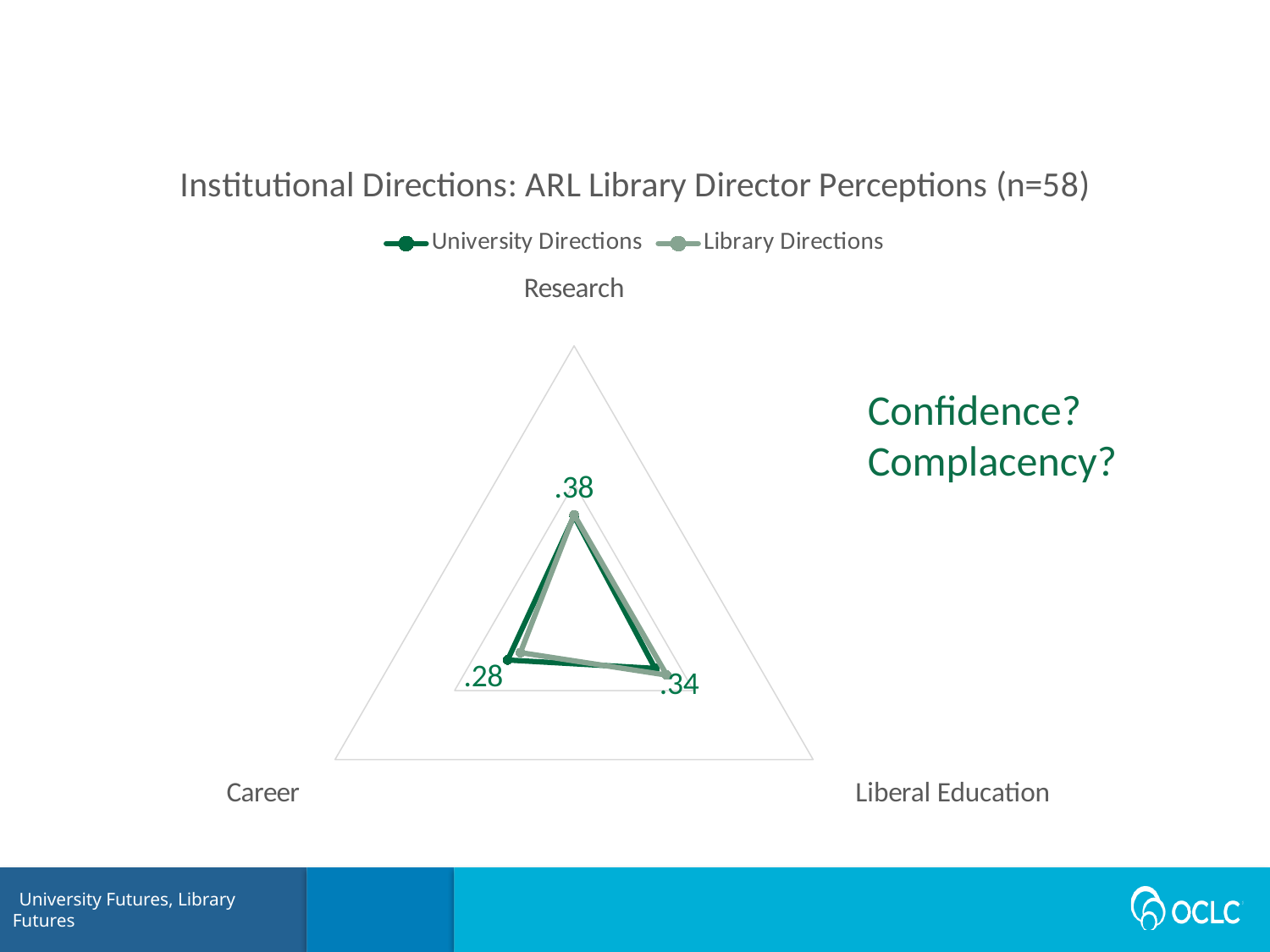
Which axis has the lowest labeled value in the chart? Career What is the title of the chart? Institutional Directions: ARL Library Director Perceptions (n=58) Which two series are listed in the chart legend? University Directions and Library Directions What kind of chart is shown on the slide? Radar chart How many series does the chart legend list? 2 Which axis has the highest labeled value in the chart? Research What is the difference between the labeled values for Research and Career? .10 Which labeled value is larger, Liberal Education or Career? Liberal Education What value is labeled on the Liberal Education axis of the chart? .34 How many axes (categories) does the radar chart have? 3 What value is labeled on the Career axis of the chart? .28 What value is labeled on the Research axis of the chart? .38